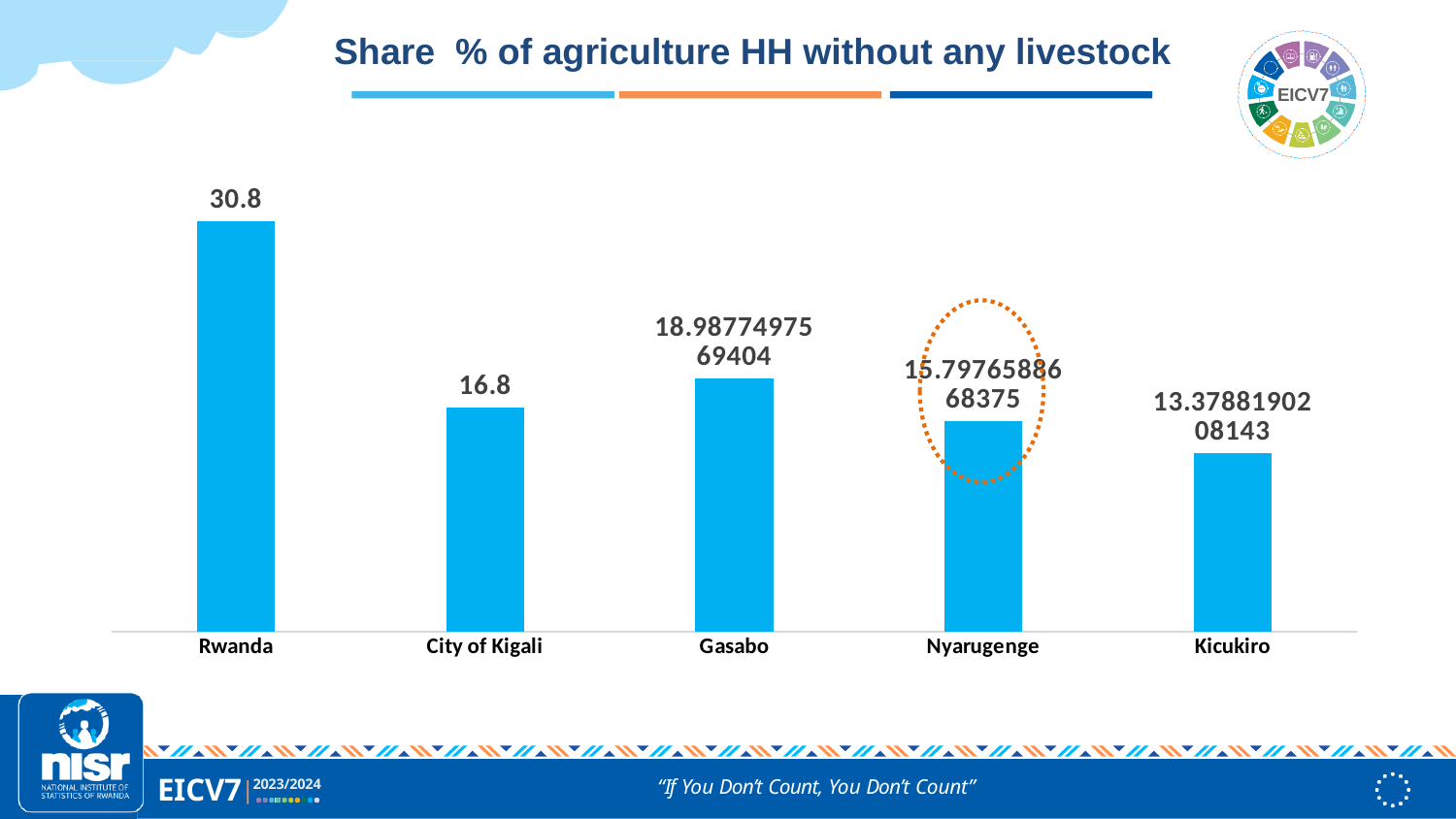
How many categories are shown on the x axis? 5 What is the difference between the values for Rwanda and City of Kigali? 14.0 What kind of chart is shown on the slide? Bar chart What is the value for City of Kigali? 16.8 Which category has the lowest value? Kicukiro Which is larger, the value for Gasabo or the value for Nyarugenge? Gasabo What is the value shown for Nyarugenge? 15.7976588668375 What is the value shown for Kicukiro? 13.3788190208143 What is the title of the chart? Share % of agriculture HH without any livestock What is the value for Rwanda? 30.8 What is the value shown for Gasabo? 18.9877497569404 Which category has the highest value? Rwanda